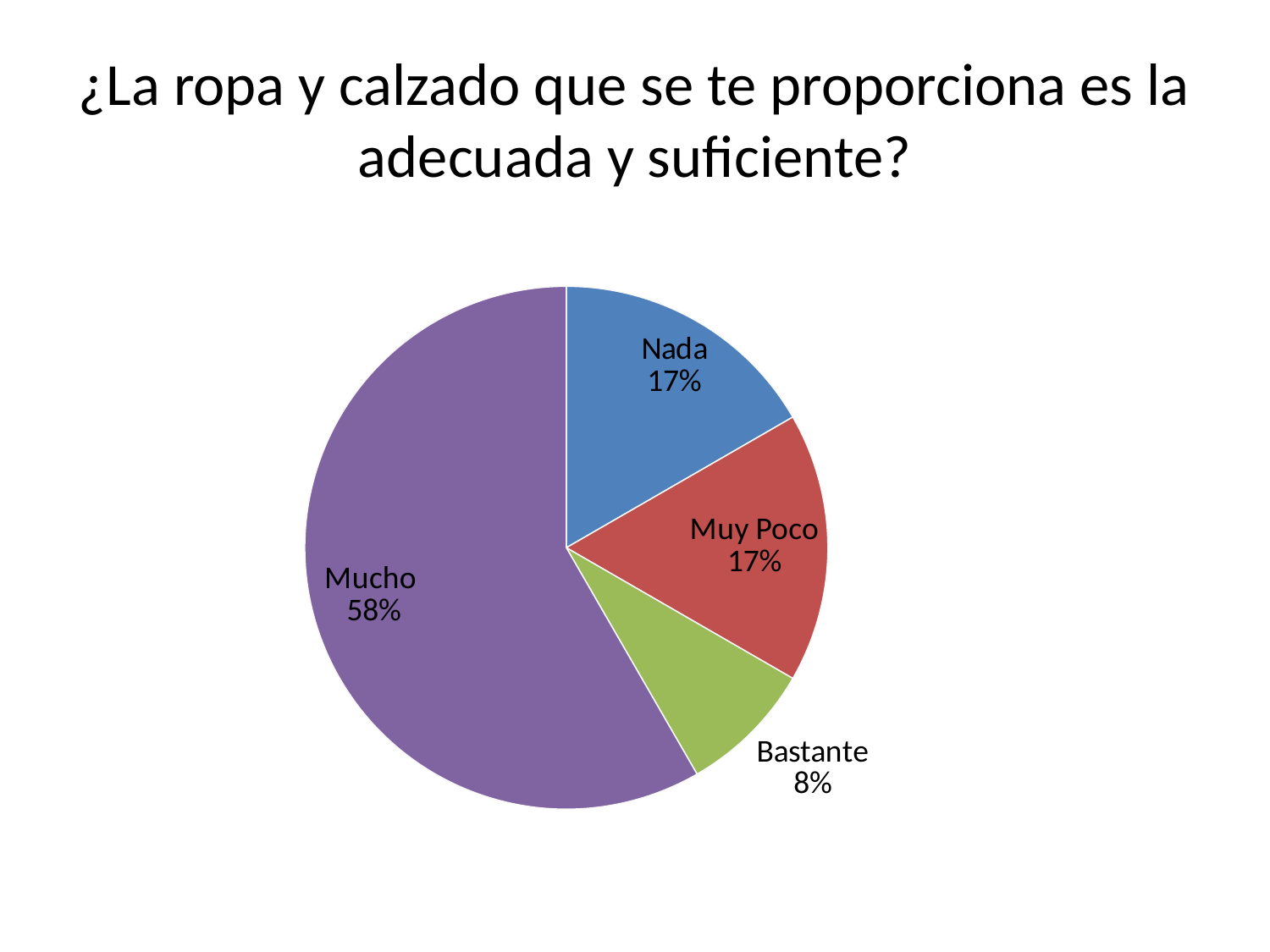
How many slices does the pie chart have? 4 Which category has the smallest slice of the pie? Bastante What is the value shown for Bastante? 8% What is the value shown for Nada? 17% Which is larger, the Nada slice or the Bastante slice? Nada What is the difference between the Mucho and Bastante percentages? 50% What is the title of the chart on the slide? ¿La ropa y calzado que se te proporciona es la adecuada y suficiente? What colour is the Mucho slice? purple What is the value shown for Muy Poco? 17% Which category has the largest slice of the pie? Mucho What share of the pie does the Mucho slice represent? 58% What kind of chart is shown on the slide? pie chart